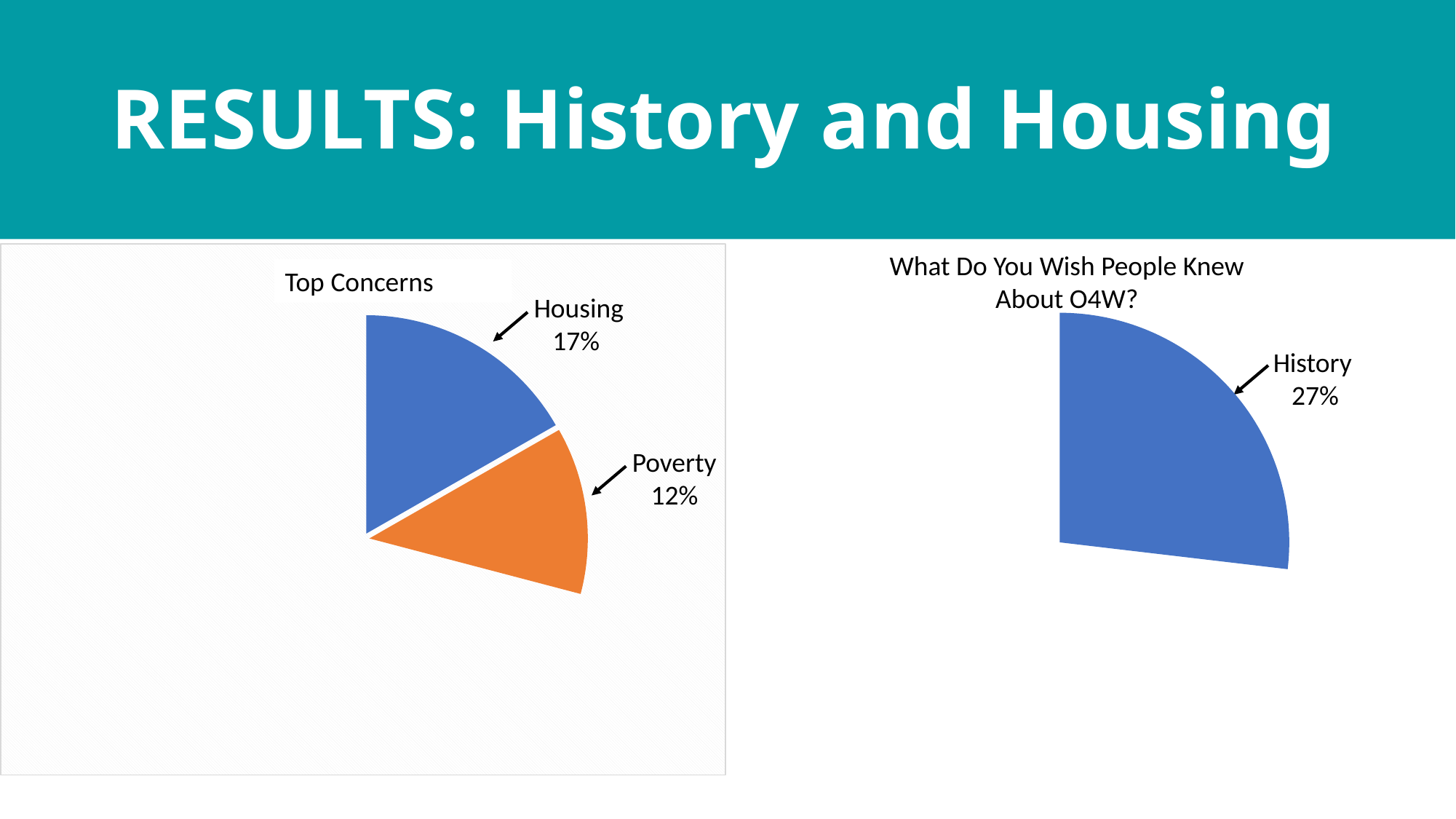
In the 'Top Concerns' chart, what is the difference in percentage points between Housing and Poverty? 5 In the 'Top Concerns' chart, what percentage is shown for Housing? 17% In the 'Top Concerns' chart, which labeled category has the highest percentage? Housing In the 'Top Concerns' chart, what colour is the Poverty slice? Orange In the 'Top Concerns' chart, which labeled category has the lowest percentage? Poverty What type of chart is the 'Top Concerns' chart? Pie chart In the 'Top Concerns' chart, which labeled slice is larger, Housing or Poverty? Housing In the 'What Do You Wish People Knew About O4W?' chart, what percentage is shown for History? 27% In the 'Top Concerns' chart, what percentage is shown for Poverty? 12% How many labeled slices are shown in the 'Top Concerns' chart? 2 What type of chart is the 'What Do You Wish People Knew About O4W?' chart? Pie chart How many labeled slices are shown in the 'What Do You Wish People Knew About O4W?' chart? 1